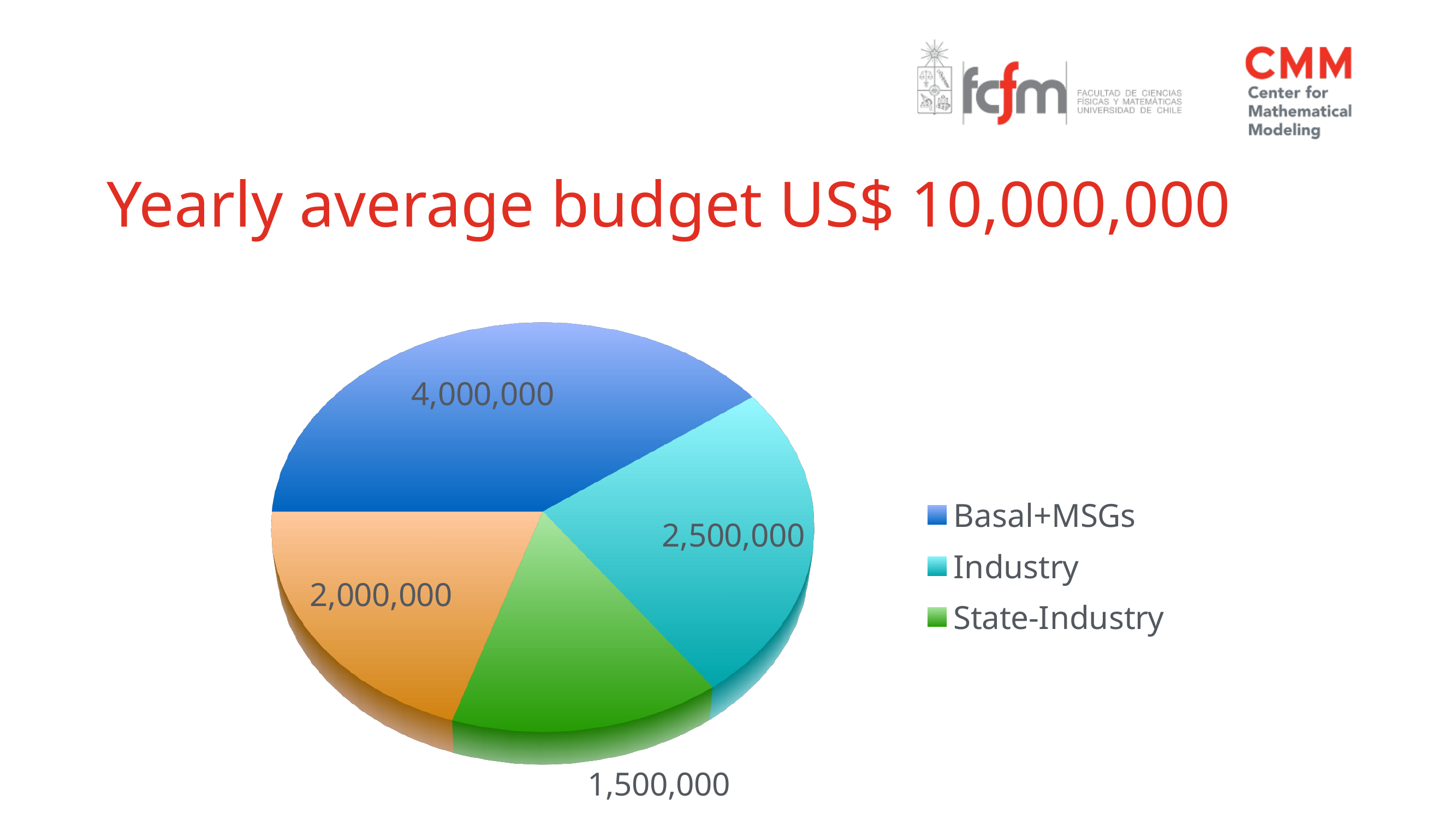
What is the title of the slide above the pie chart? Yearly average budget US$ 10,000,000 What is the difference between the Basal+MSGs value and the Industry value? 1,500,000 Which legend category has the largest slice of the pie? Basal+MSGs What share of the pie does the Basal+MSGs slice represent? 40% What is the value of the Industry slice? 2,500,000 What is the value of the Basal+MSGs slice? 4,000,000 What is the value of the State-Industry slice? 1,500,000 How many entries does the legend list? 3 Which legend category has the smallest slice of the pie? State-Industry Which is larger, the Industry slice or the State-Industry slice? Industry How many slices does the pie chart have? 4 What kind of chart is shown on the slide? pie chart